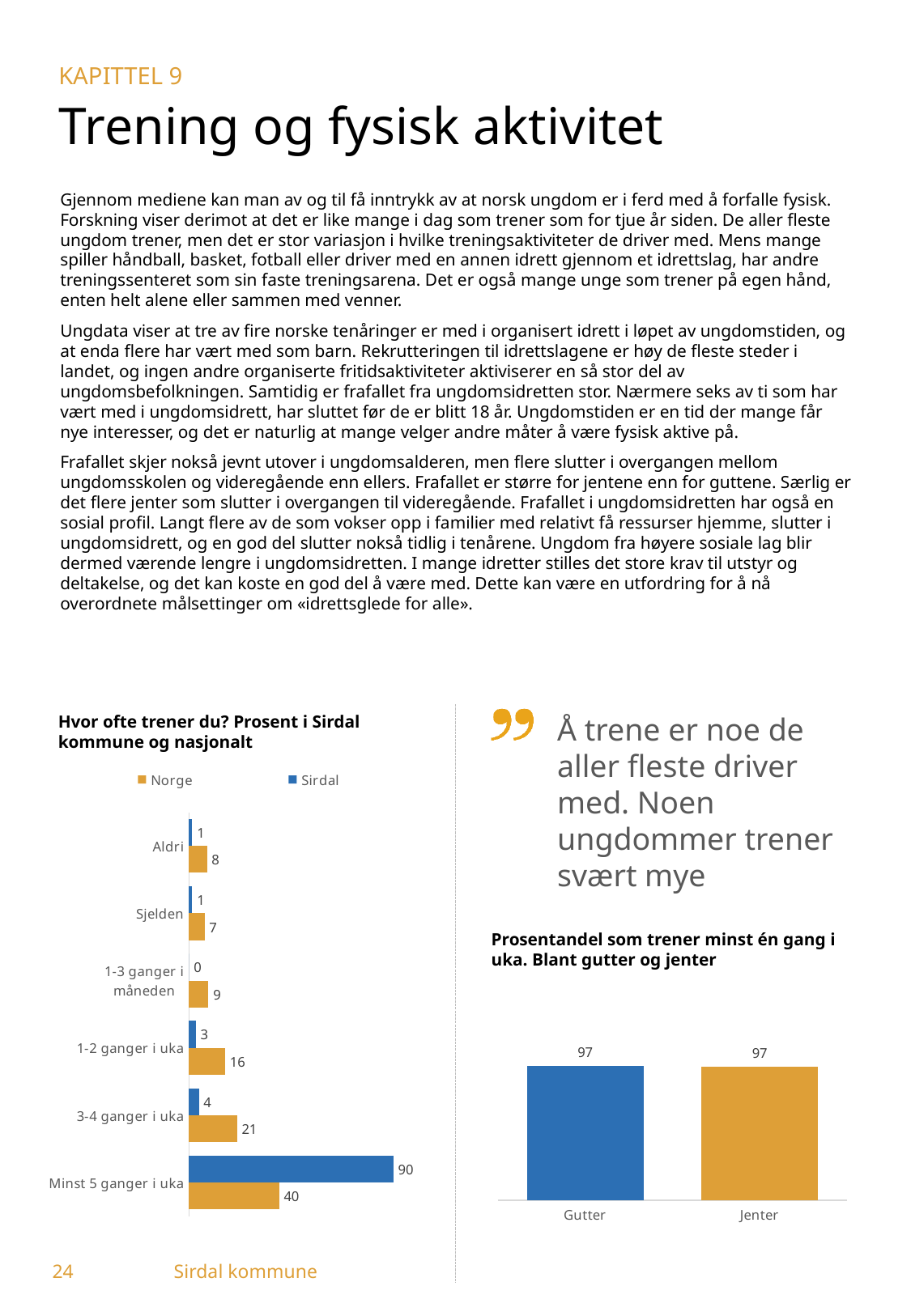
In the chart 'Hvor ofte trener du? Prosent i Sirdal kommune og nasjonalt', what is the value for Norge in the category '3-4 ganger i uka'? 21 In the chart 'Hvor ofte trener du? Prosent i Sirdal kommune og nasjonalt', which category has the highest value for Norge? Minst 5 ganger i uka How many categories are shown in the chart 'Hvor ofte trener du? Prosent i Sirdal kommune og nasjonalt'? 6 In the chart 'Prosentandel som trener minst én gang i uka. Blant gutter og jenter', what is the value for Jenter? 97 In the chart 'Hvor ofte trener du? Prosent i Sirdal kommune og nasjonalt', which is larger for '1-2 ganger i uka': Norge or Sirdal? Norge In the chart 'Hvor ofte trener du? Prosent i Sirdal kommune og nasjonalt', what is the value for Sirdal in the category 'Minst 5 ganger i uka'? 90 In the chart 'Hvor ofte trener du? Prosent i Sirdal kommune og nasjonalt', what is the difference between the Sirdal and Norge values for 'Minst 5 ganger i uka'? 50 In the chart 'Hvor ofte trener du? Prosent i Sirdal kommune og nasjonalt', which colour represents the Norge series? Orange In the chart 'Hvor ofte trener du? Prosent i Sirdal kommune og nasjonalt', what is the value for Sirdal in the category '1-3 ganger i måneden'? 0 How many series does the legend list in the chart 'Hvor ofte trener du? Prosent i Sirdal kommune og nasjonalt'? 2 What kind of chart is 'Prosentandel som trener minst én gang i uka. Blant gutter og jenter'? Bar chart In the chart 'Hvor ofte trener du? Prosent i Sirdal kommune og nasjonalt', which category has the lowest value for Sirdal? 1-3 ganger i måneden